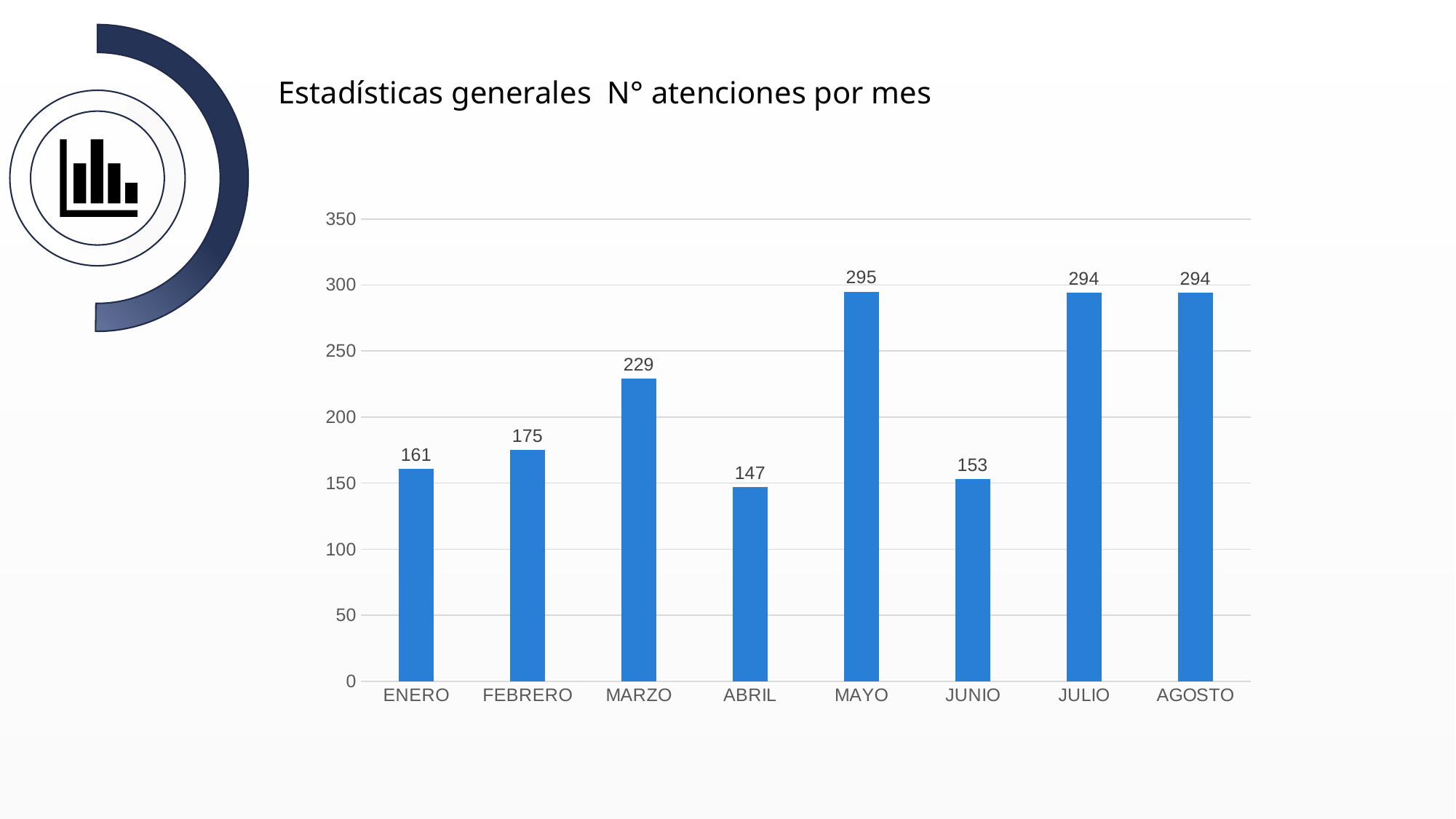
Which month has the highest value? MAYO What is the difference between the values for MAYO and ABRIL? 148 What kind of chart is shown on the slide? bar chart What is the difference between the values for FEBRERO and ENERO? 14 What is the value for MARZO? 229 How many months are shown on the x axis? 8 What is the value for ENERO? 161 Which is larger, the value for MARZO or the value for FEBRERO? MARZO Is the value for JULIO greater or less than 250? greater What is the title of the slide? Estadísticas generales N° atenciones por mes What is the value for JUNIO? 153 Which month has the lowest value? ABRIL